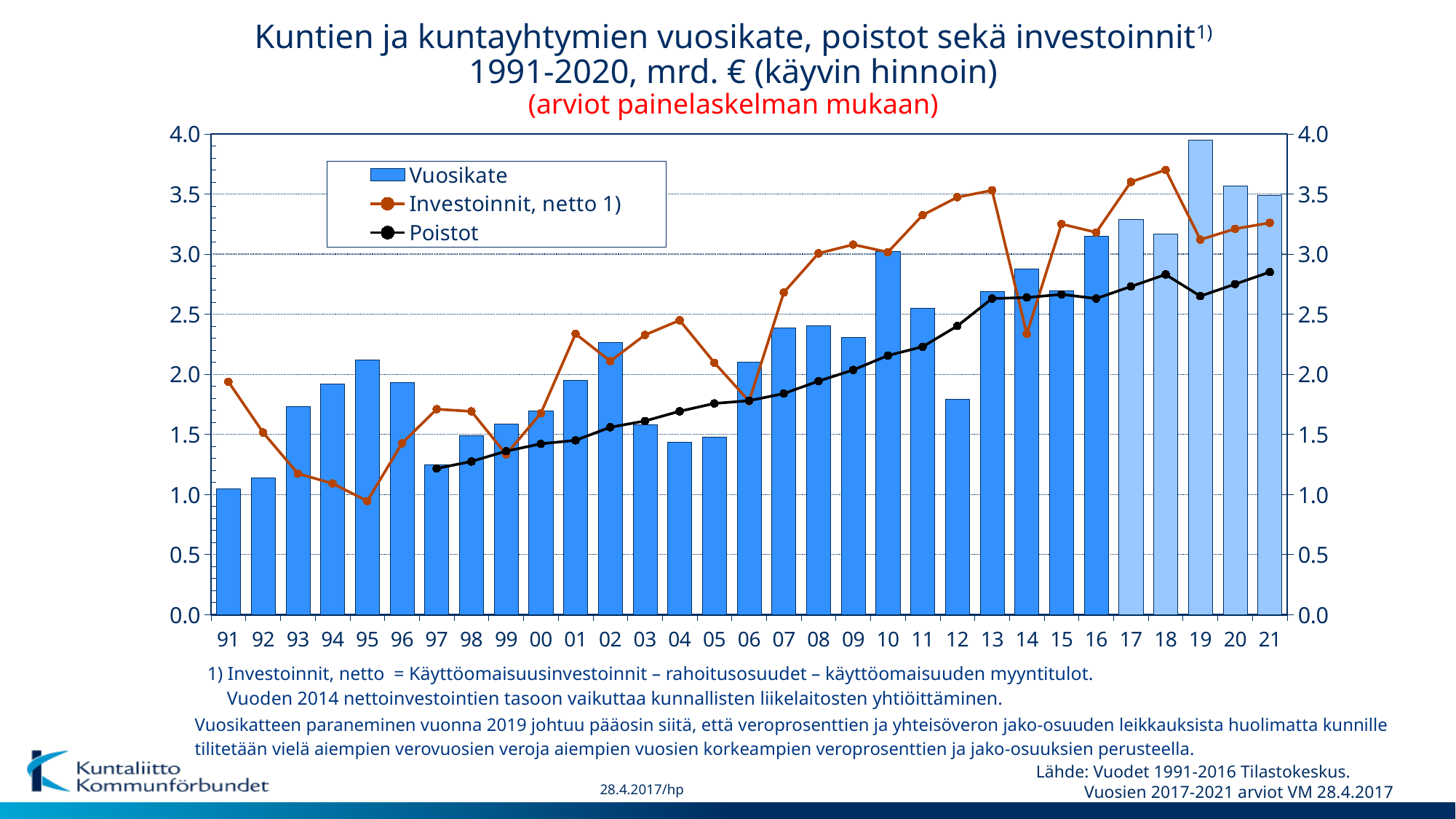
Which year has the highest Vuosikate bar? 19 What kind of chart is shown on the slide? A combined bar and line chart In which year is the Investoinnit, netto line at its highest? 18 Which series is drawn as a black line with circular markers? Poistot Which is larger, the Investoinnit, netto value for 13 or for 14? 13 Is the Vuosikate value for 12 greater or less than 2.0? less Is the Investoinnit, netto value for 14 greater or less than 2.5? less Is the Vuosikate value for 19 greater or less than 3.5? greater In which year is the Investoinnit, netto line at its lowest? 95 Which year has the lowest Vuosikate bar? 91 Does the Poistot line generally rise or fall from 97 to 21? rise How many series does the legend list? 3